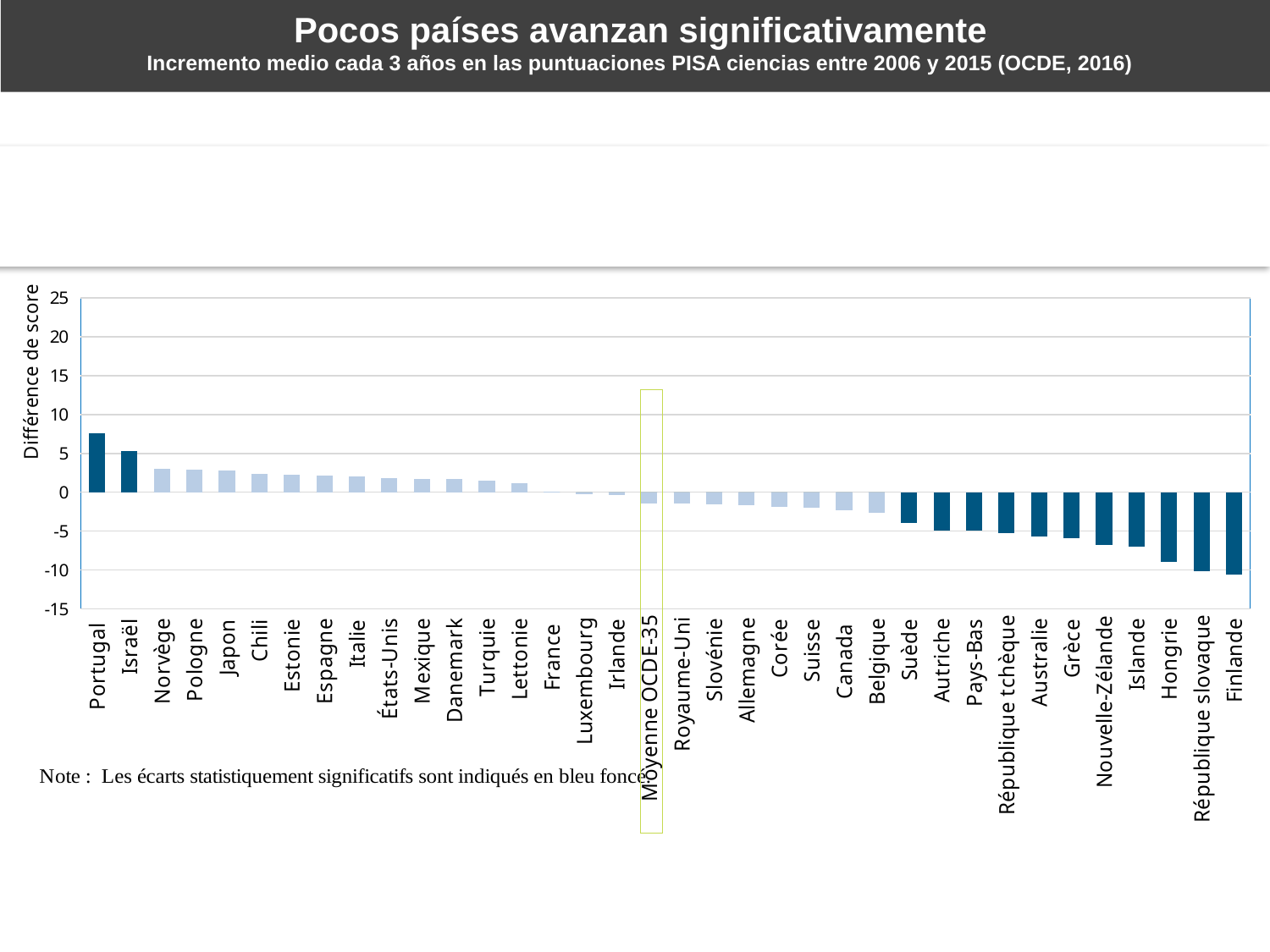
Which has the larger value, Islande or Hongrie? Islande Which country has the highest value in the chart? Portugal Is the value for Norvège greater or less than 5? less How many categories (bars) are plotted along the x axis? 36 Do the values rise or fall moving from left to right along the x axis? Fall Is the value for Hongrie greater or less than -5? less What kind of chart is shown on the slide? Bar chart What is the title of the vertical axis? Différence de score Is the value for Canada greater or less than 0? less Which has the larger value, Portugal or Israël? Portugal